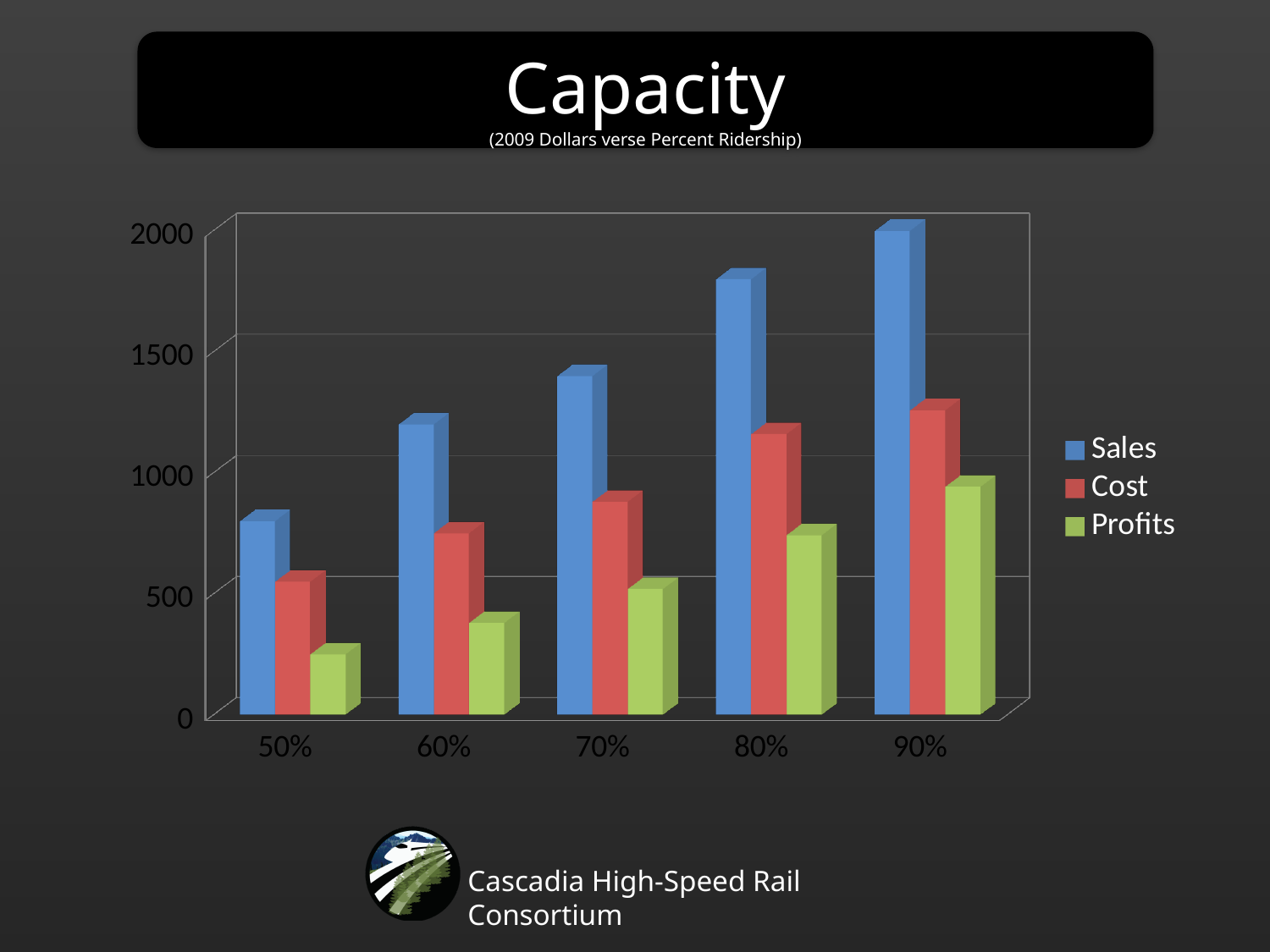
Is the Cost value at 60% ridership greater or less than 1000? less How many ridership percentage categories are shown on the x axis? 5 At which ridership percentage is Sales highest? 90% At which ridership percentage is Profits lowest? 50% What is the subtitle printed under the chart title "Capacity"? (2009 Dollars verse Percent Ridership) Is the Sales value at 80% ridership greater or less than 1500? greater Is the Profits value at 50% ridership greater or less than 500? less How many series does the legend list? 3 Which series is shown in blue in the legend? Sales What kind of chart is shown on the slide? bar chart At 80% ridership, which is larger, Sales or Cost? Sales Do Sales values rise or fall as ridership increases from 50% to 90%? rise